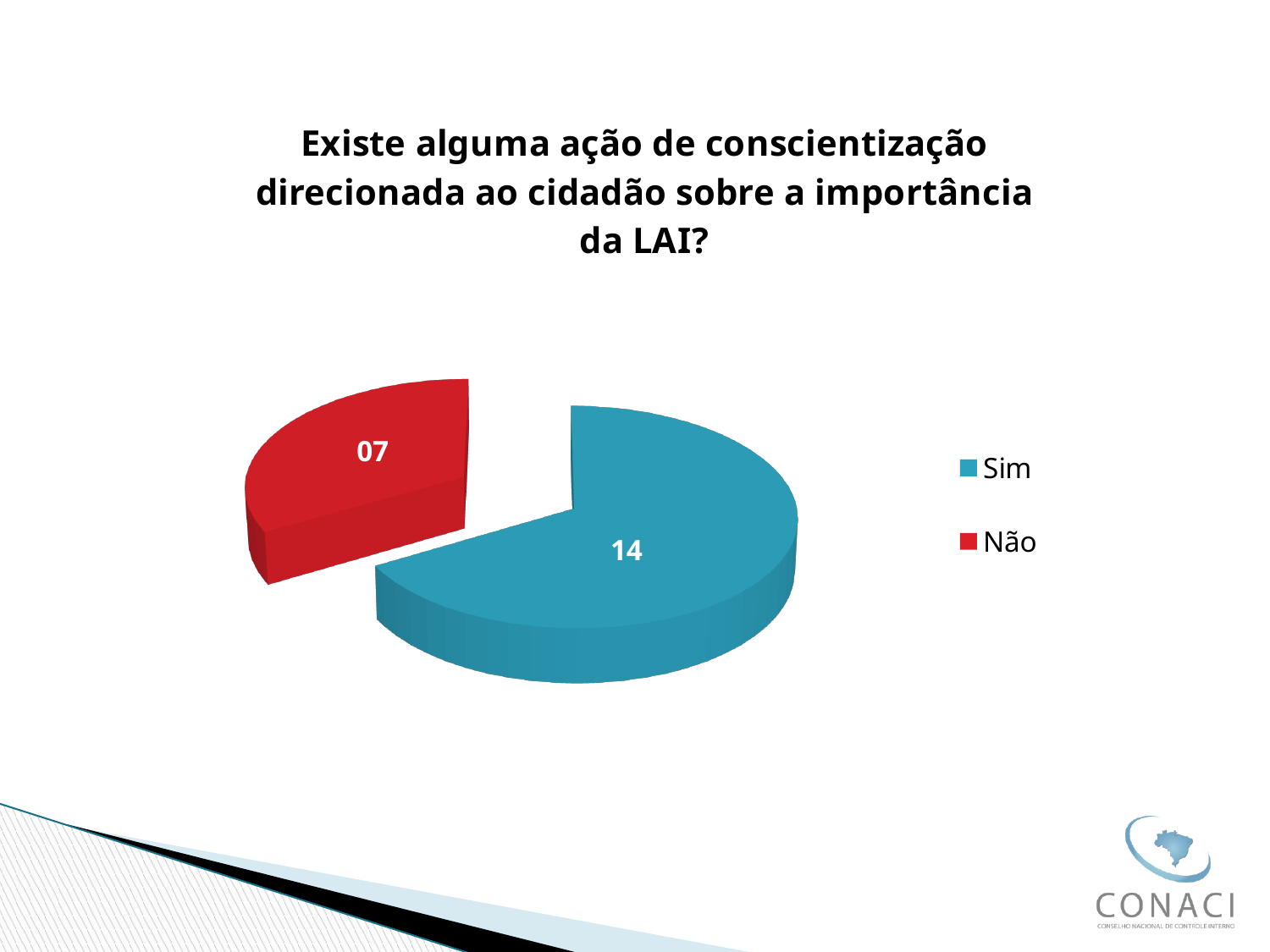
What is the total of all slices in the pie chart? 21 What is the value for Não? 07 What is the title of the chart? Existe alguma ação de conscientização direcionada ao cidadão sobre a importância da LAI? Which category has the smallest slice? Não What is the value for Sim? 14 What kind of chart is shown on the slide? pie chart How many slices does the pie chart have? 2 How many entries does the legend list? 2 What is the difference between the values for Sim and Não? 7 Which category has the largest slice? Sim What colour is the Não slice? red Which is larger, the value for Sim or the value for Não? Sim